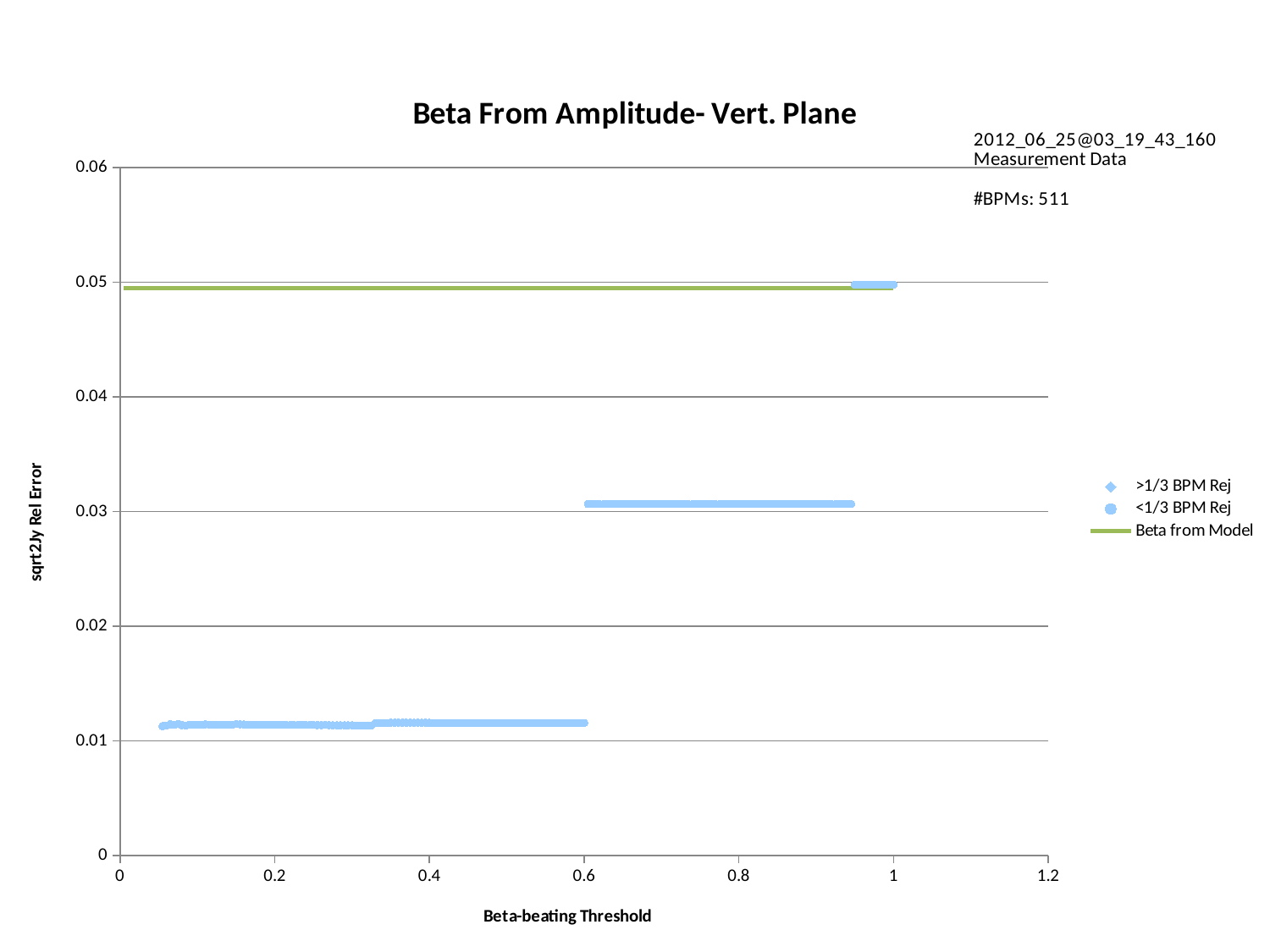
Is the value of the <1/3 BPM Rej points at a Beta-beating Threshold of 0.8 greater or less than 0.04? less What is the title of the chart? Beta From Amplitude- Vert. Plane How many BPMs does the slide state were used? 511 How many series does the chart legend list? 3 Is the Beta from Model line greater or less than 0.04? greater Is the value of the <1/3 BPM Rej points at a Beta-beating Threshold of 0.8 greater or less than 0.02? greater What type of chart is shown on the slide? scatter chart Which is larger: the <1/3 BPM Rej value at a Beta-beating Threshold of 0.8 or at 0.4? 0.8 Do the plotted <1/3 BPM Rej values rise or fall as the Beta-beating Threshold increases? rise What is the label of the x axis? Beta-beating Threshold